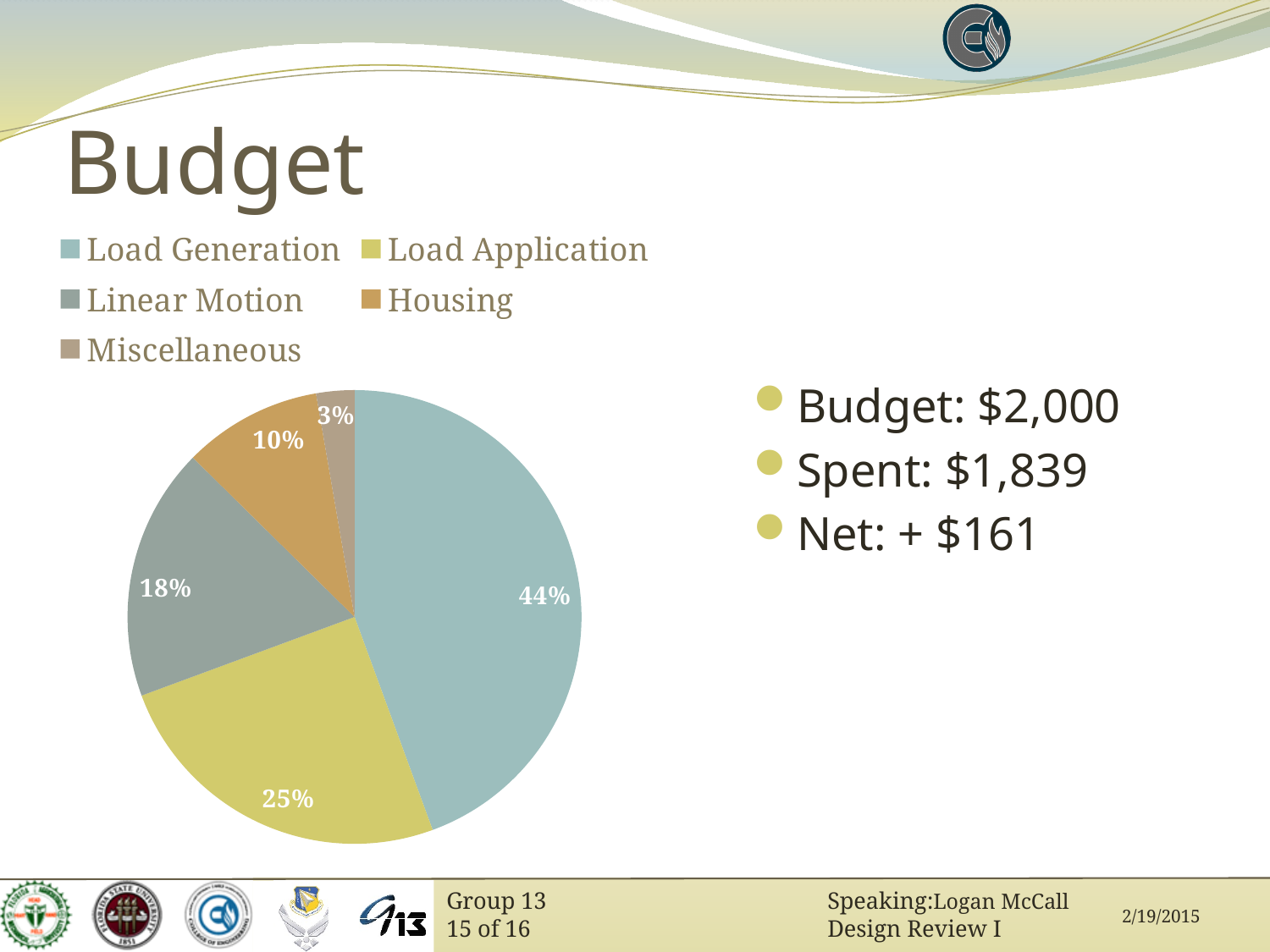
Which is larger, the Linear Motion slice or the Housing slice? Linear Motion What kind of chart is shown on the slide? pie chart What share of the pie does Load Application take? 25% Which category has the smallest slice of the pie? Miscellaneous What share of the pie does Housing take? 10% What share of the pie does Linear Motion take? 18% Which category has the largest slice of the pie? Load Generation How many categories does the pie chart have? 5 What is the difference in percentage points between Load Generation and Load Application? 19 What is the title of the slide containing the pie chart? Budget